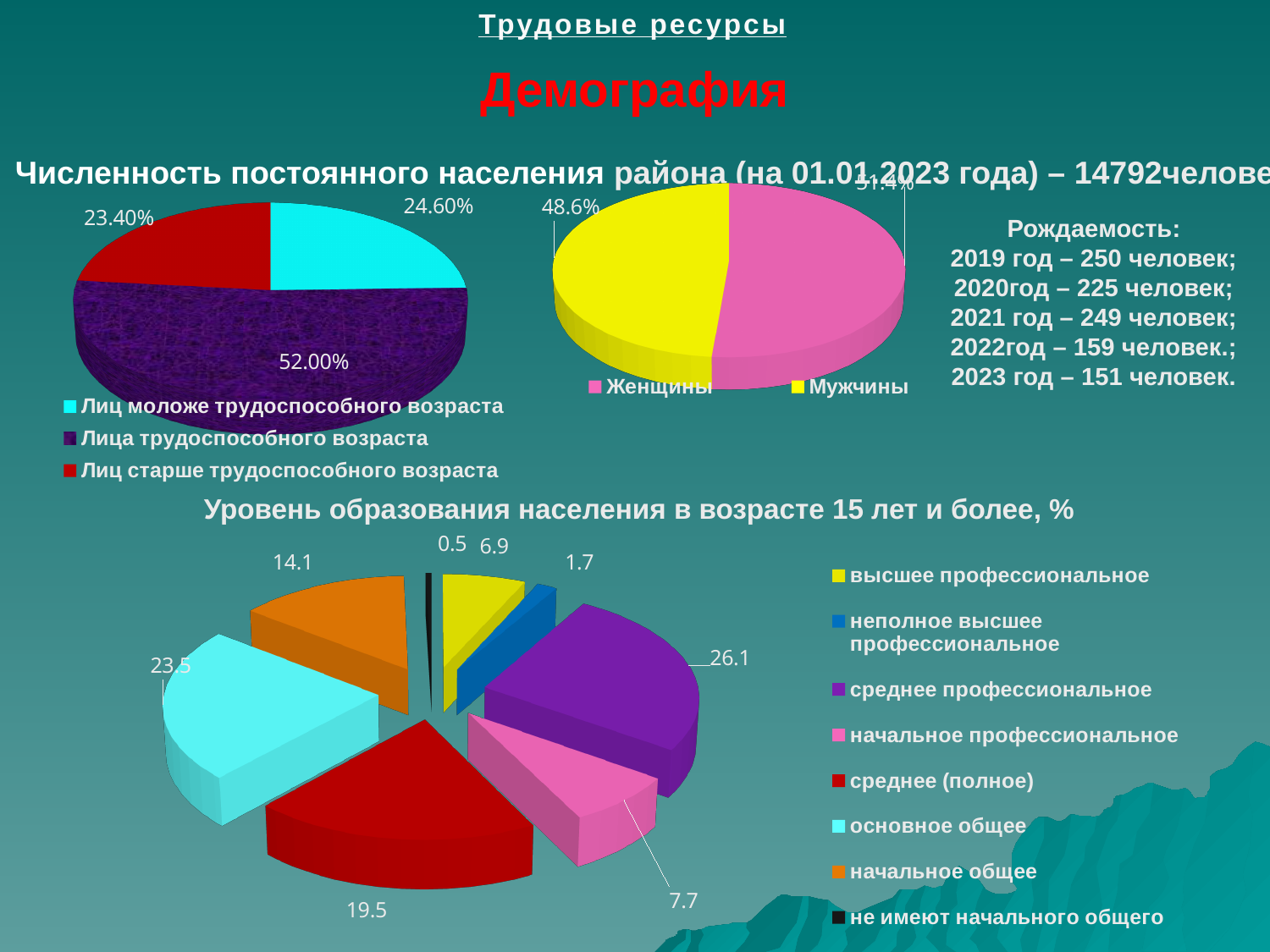
In the top-middle pie chart on gender, which group has the larger share, 'Женщины' or 'Мужчины'? Женщины In the top-left pie chart on age structure, what is the difference between the shares for 'Лиц моложе трудоспособного возраста' and 'Лиц старше трудоспособного возраста'? 1.20% How many categories does the legend of the top-left pie chart on age structure list? 3 In the chart 'Уровень образования населения в возрасте 15 лет и более, %', which category has the smallest value? не имеют начального общего In the chart 'Уровень образования населения в возрасте 15 лет и более, %', what is the difference between 'основное общее' and 'среднее (полное)'? 4.0 In the top-middle pie chart on gender, what share is shown for 'Мужчины'? 48.6% In the top-left pie chart on age structure, which category has the largest share? Лица трудоспособного возраста In the top-left pie chart on age structure, what share is shown for 'Лица трудоспособного возраста'? 52.00% In the chart 'Уровень образования населения в возрасте 15 лет и более, %', what value is shown for 'среднее профессиональное'? 26.1 What type of chart is 'Уровень образования населения в возрасте 15 лет и более, %'? Pie chart In the top-left pie chart on age structure, what share is shown for 'Лиц старше трудоспособного возраста'? 23.40% How many categories does the legend of the chart 'Уровень образования населения в возрасте 15 лет и более, %' list? 8